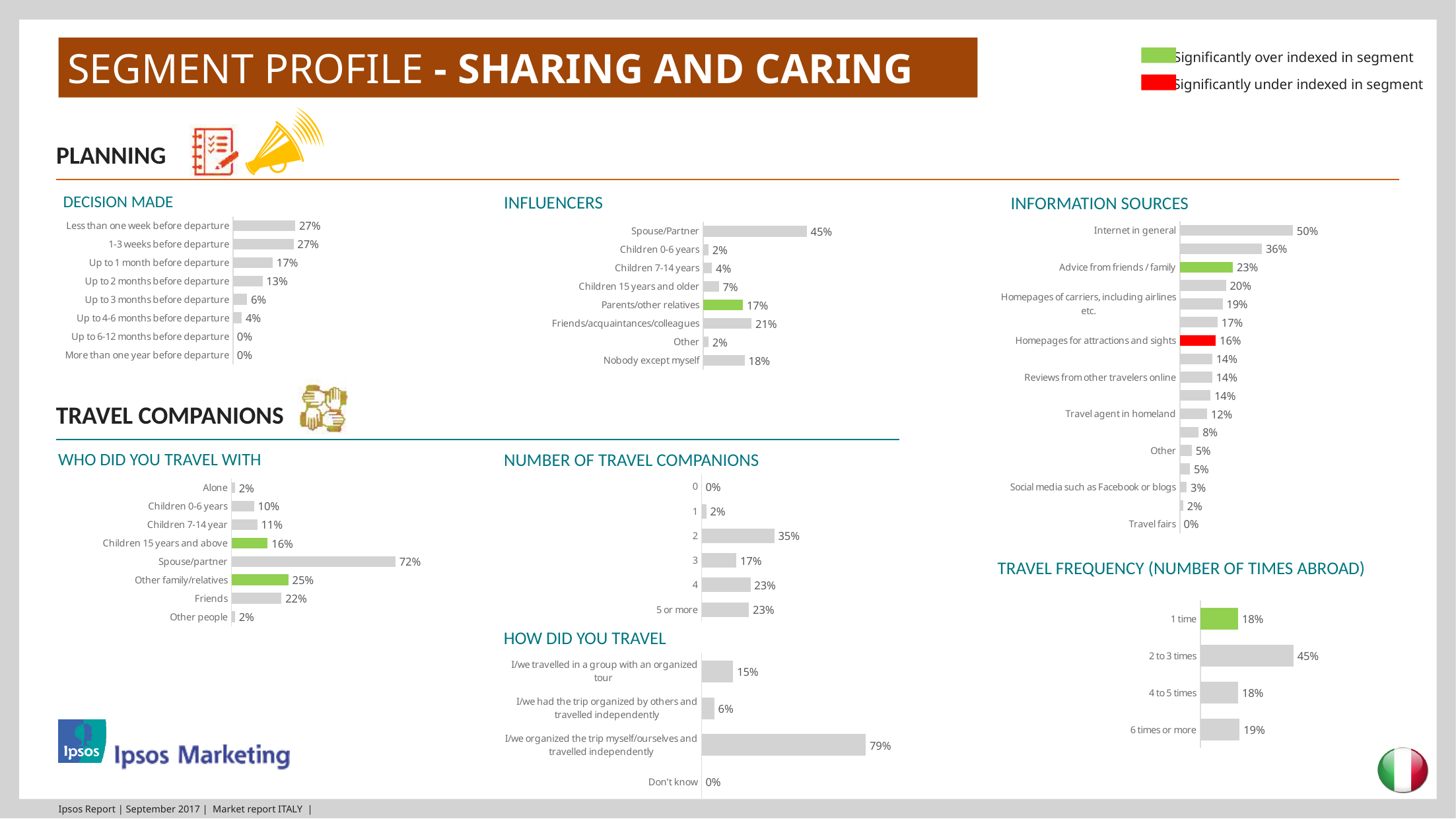
In the WHO DID YOU TRAVEL WITH chart, how many categories are shown? 8 In the INFLUENCERS chart, what is the difference between 'Friends/acquaintances/colleagues' and 'Parents/other relatives'? 4% In the NUMBER OF TRAVEL COMPANIONS chart, what is the value for '2'? 35% In the INFORMATION SOURCES chart, which is larger: 'Advice from friends / family' or 'Travel agent in homeland'? Advice from friends / family In the INFORMATION SOURCES chart, what is the value for 'Homepages for attractions and sights'? 16% What type of chart is the TRAVEL FREQUENCY (NUMBER OF TIMES ABROAD) chart? Bar chart In the DECISION MADE chart, what is the value for 'Up to 1 month before departure'? 17% In the TRAVEL FREQUENCY (NUMBER OF TIMES ABROAD) chart, which category has the highest value? 2 to 3 times In the INFLUENCERS chart, which category has the highest value? Spouse/Partner In the WHO DID YOU TRAVEL WITH chart, which bars are coloured green? Children 15 years and above and Other family/relatives In the WHO DID YOU TRAVEL WITH chart, which category has the highest value? Spouse/partner In the HOW DID YOU TRAVEL chart, what is the value for 'I/we organized the trip myself/ourselves and travelled independently'? 79%